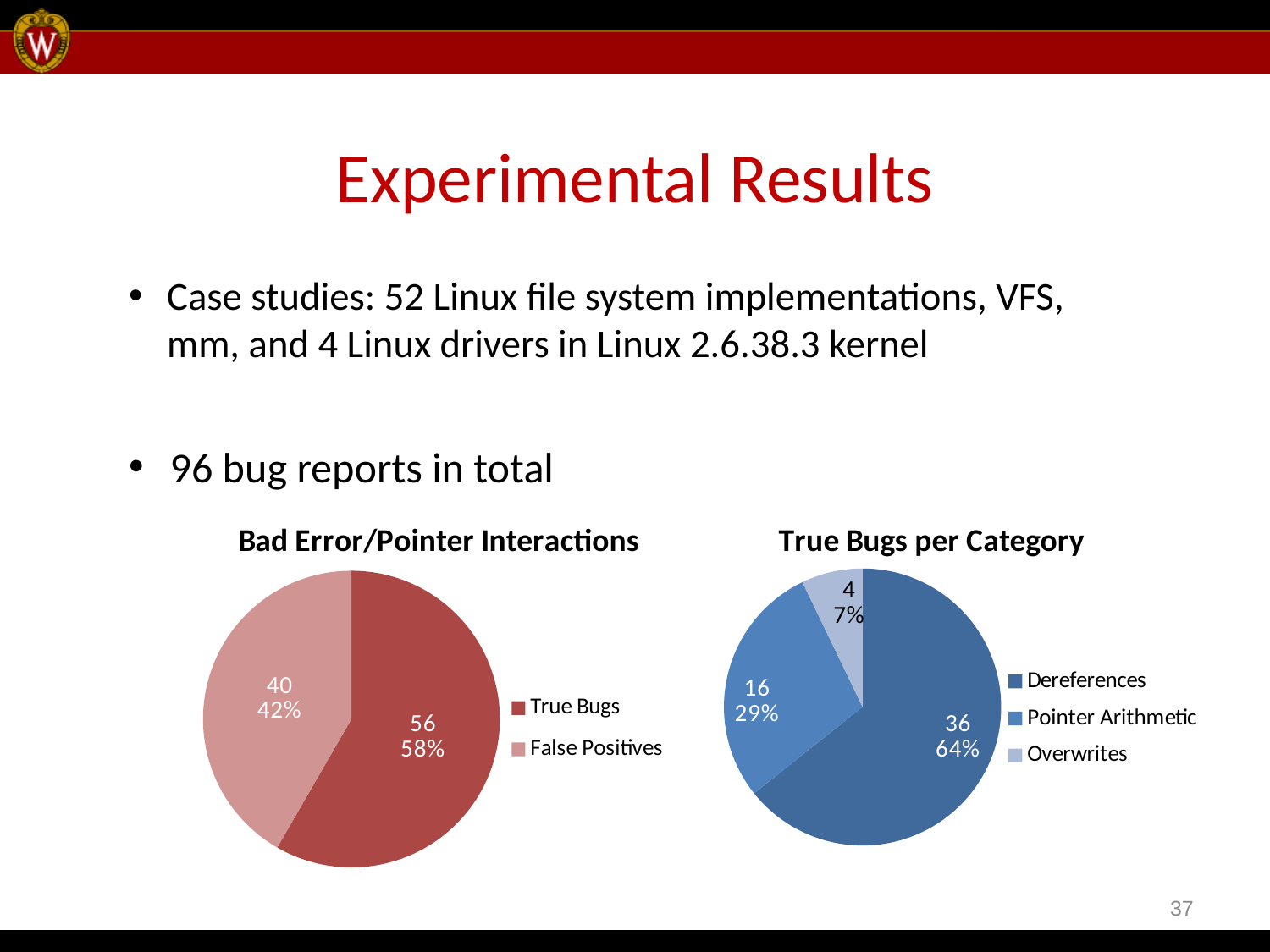
In the 'Bad Error/Pointer Interactions' chart, what share of the pie is False Positives? 42% In the 'True Bugs per Category' chart, which category has the most bugs? Dereferences In the 'Bad Error/Pointer Interactions' chart, which slice is larger, True Bugs or False Positives? True Bugs What type of chart is 'True Bugs per Category'? Pie chart In the 'True Bugs per Category' chart, which category has the fewest bugs? Overwrites In the 'True Bugs per Category' chart, how many bugs are in the Pointer Arithmetic category? 16 In the 'True Bugs per Category' chart, what is the difference between Dereferences and Overwrites? 32 In the 'True Bugs per Category' chart, what share of the pie is Dereferences? 64% In the 'Bad Error/Pointer Interactions' chart, how many True Bugs are there? 56 How many categories does the legend of the 'True Bugs per Category' chart list? 3 In the 'True Bugs per Category' chart, what is the total of all three categories? 56 In the 'Bad Error/Pointer Interactions' chart, what is the difference between True Bugs and False Positives? 16